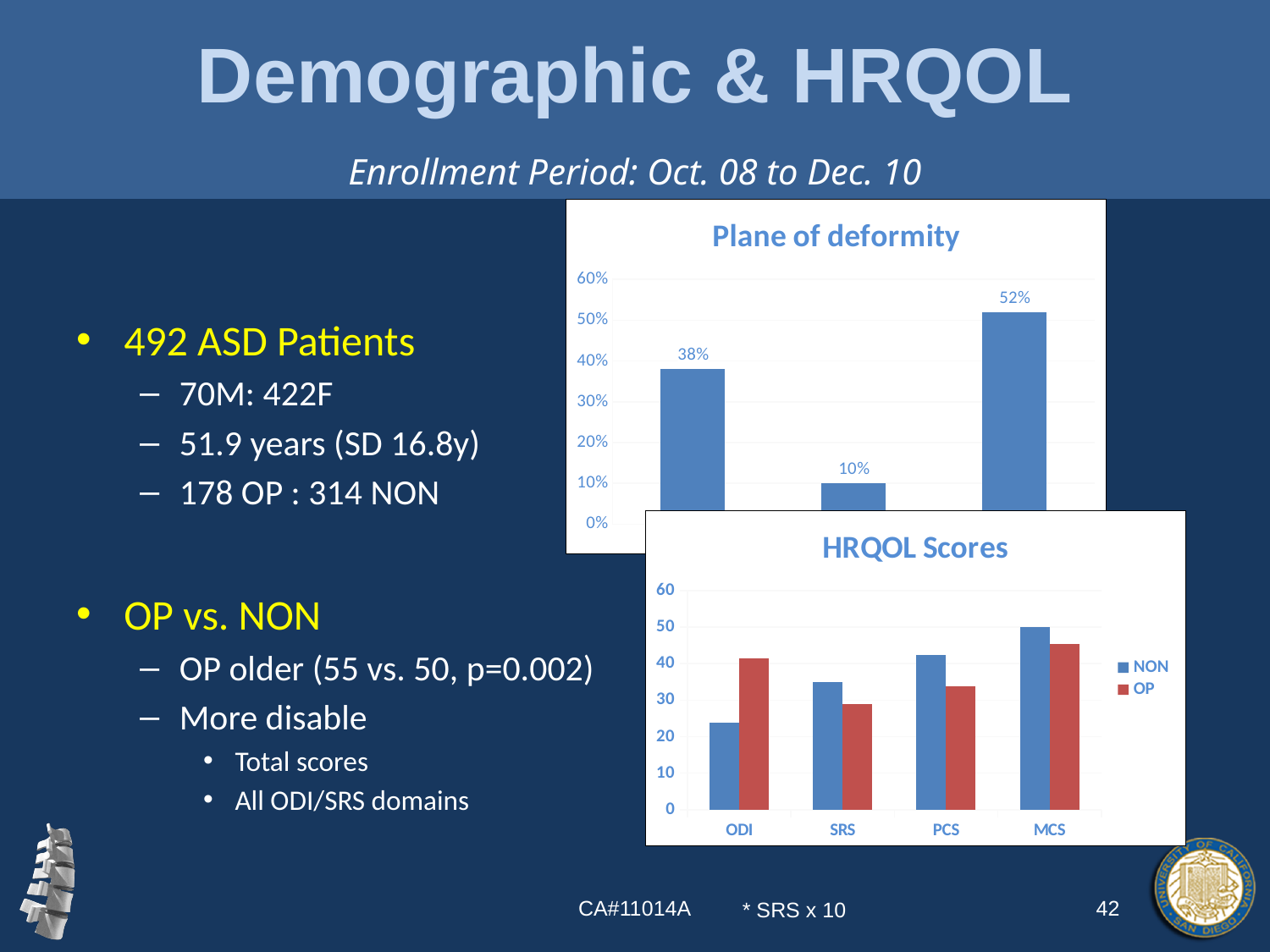
In the 'HRQOL Scores' chart, which category has the lowest NON value? ODI How many bars are shown in the 'Plane of deformity' chart? 3 In the 'Plane of deformity' chart, what is the difference between the highest and lowest bar values? 42% In the 'HRQOL Scores' chart, which colour represents the OP series? Red How many series does the legend of the 'HRQOL Scores' chart list? 2 How many categories are shown on the x axis of the 'HRQOL Scores' chart? 4 In the 'HRQOL Scores' chart, for ODI, which series has the larger value, NON or OP? OP In the 'Plane of deformity' chart, what is the lowest value shown? 10% What type of chart is the 'Plane of deformity' chart? Bar chart In the 'Plane of deformity' chart, what is the highest value shown? 52% In the 'HRQOL Scores' chart, is the NON value for ODI greater or less than 30? less In the 'HRQOL Scores' chart, which category has the highest NON value? MCS